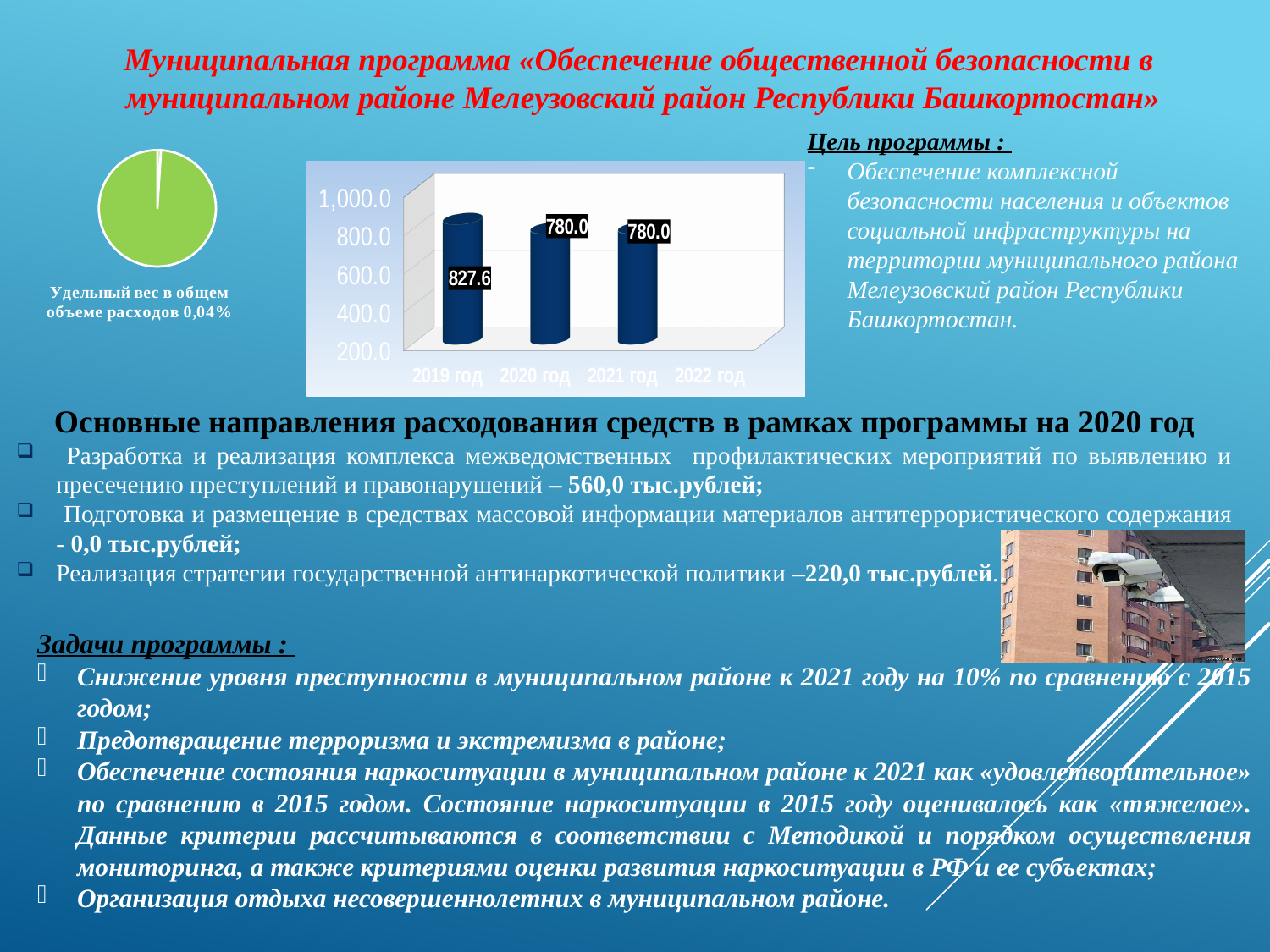
In the bar chart, which year has the highest value? 2019 год In the bar chart, what is the difference between the values for 2019 год and 2020 год? 47.6 What kind of chart is the chart in the middle of the slide showing values by year? bar chart What kind of chart is the chart on the left of the slide? pie chart In the bar chart, is the value for 2020 год greater or less than 1,000.0? less What caption is written under the pie chart on the left? Удельный вес в общем объеме расходов 0,04% In the bar chart, do the values rise or fall from 2019 год to 2020 год? fall In the bar chart, what is the value for 2021 год? 780.0 In the bar chart, which is larger: the value for 2019 год or the value for 2021 год? 2019 год How many bars are plotted in the bar chart? 3 In the bar chart, what is the value for 2019 год? 827.6 In the bar chart, what is the value for 2020 год? 780.0